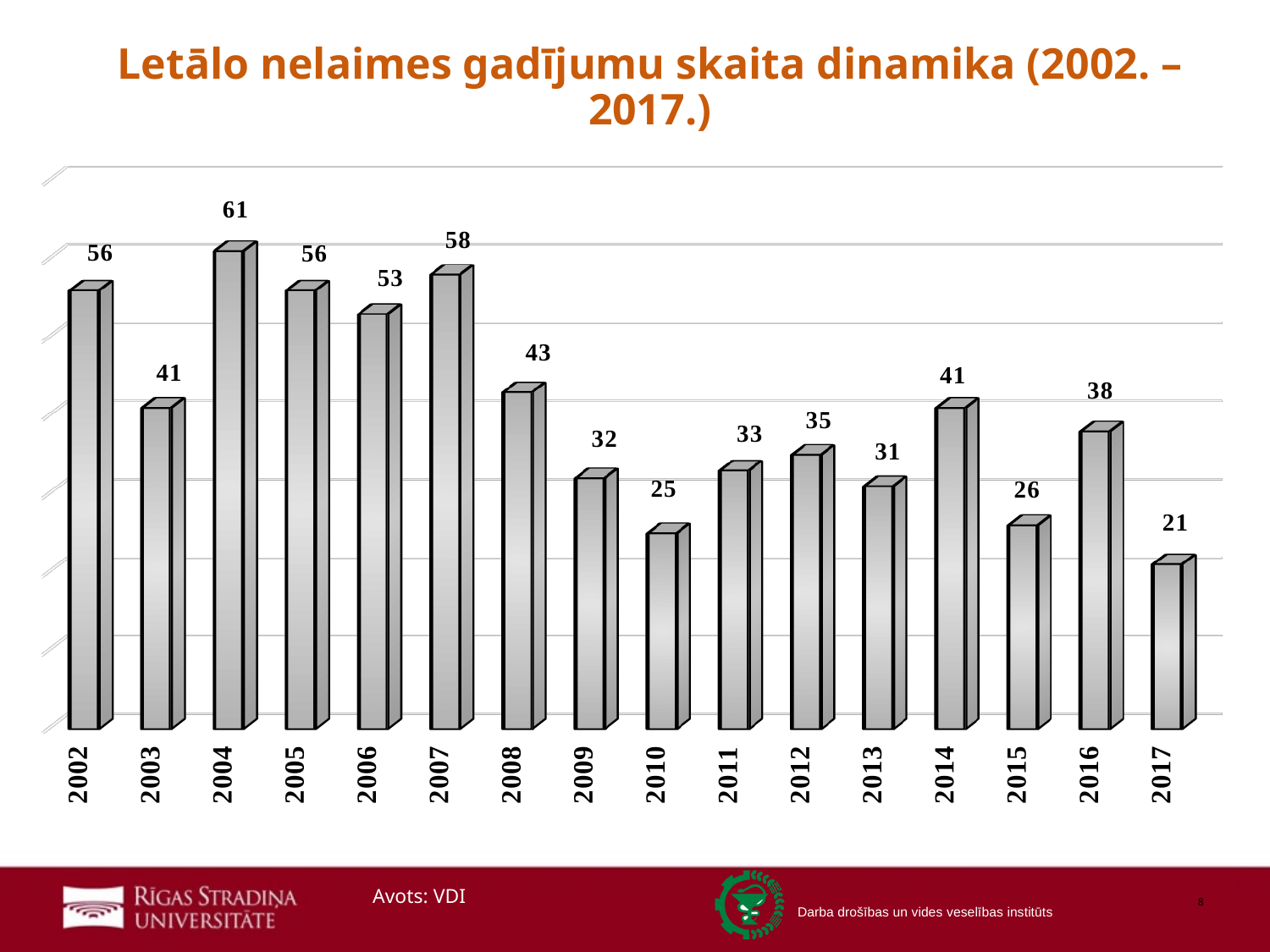
What is the difference between the values for 2004 and 2017? 40 What is the value for 2017? 21 What kind of chart is shown on the slide? bar chart What is the value for 2004? 61 Do the values generally rise or fall from 2007 to 2010? fall Which is larger, the value for 2008 or the value for 2016? 2008 How many years are shown on the x axis? 16 What is the difference between the values for 2014 and 2015? 15 What is the title of the chart? Letālo nelaimes gadījumu skaita dinamika (2002. – 2017.) Which year has the lowest value? 2017 What is the value for 2010? 25 Which year has the highest value? 2004